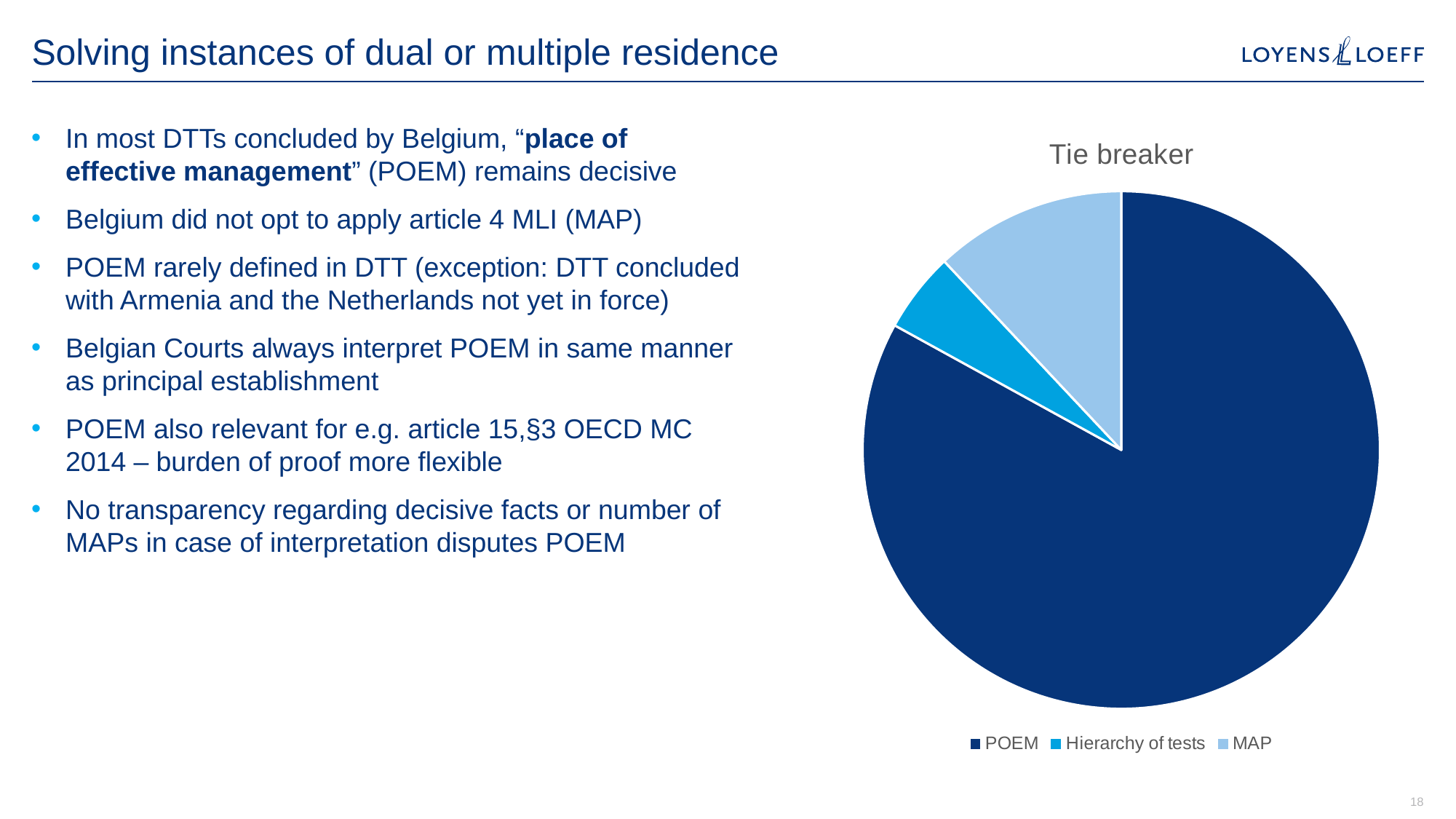
How many entries does the chart legend list? 3 What is the title of the chart? Tie breaker Which category has the smallest slice of the pie? Hierarchy of tests How many slices does the pie chart have? 3 Which slice is larger, MAP or Hierarchy of tests? MAP Which category has the largest slice of the pie? POEM What kind of chart is shown on the slide? pie chart Which slice is larger, POEM or MAP? POEM Which legend entry is shown in the lightest blue colour? MAP